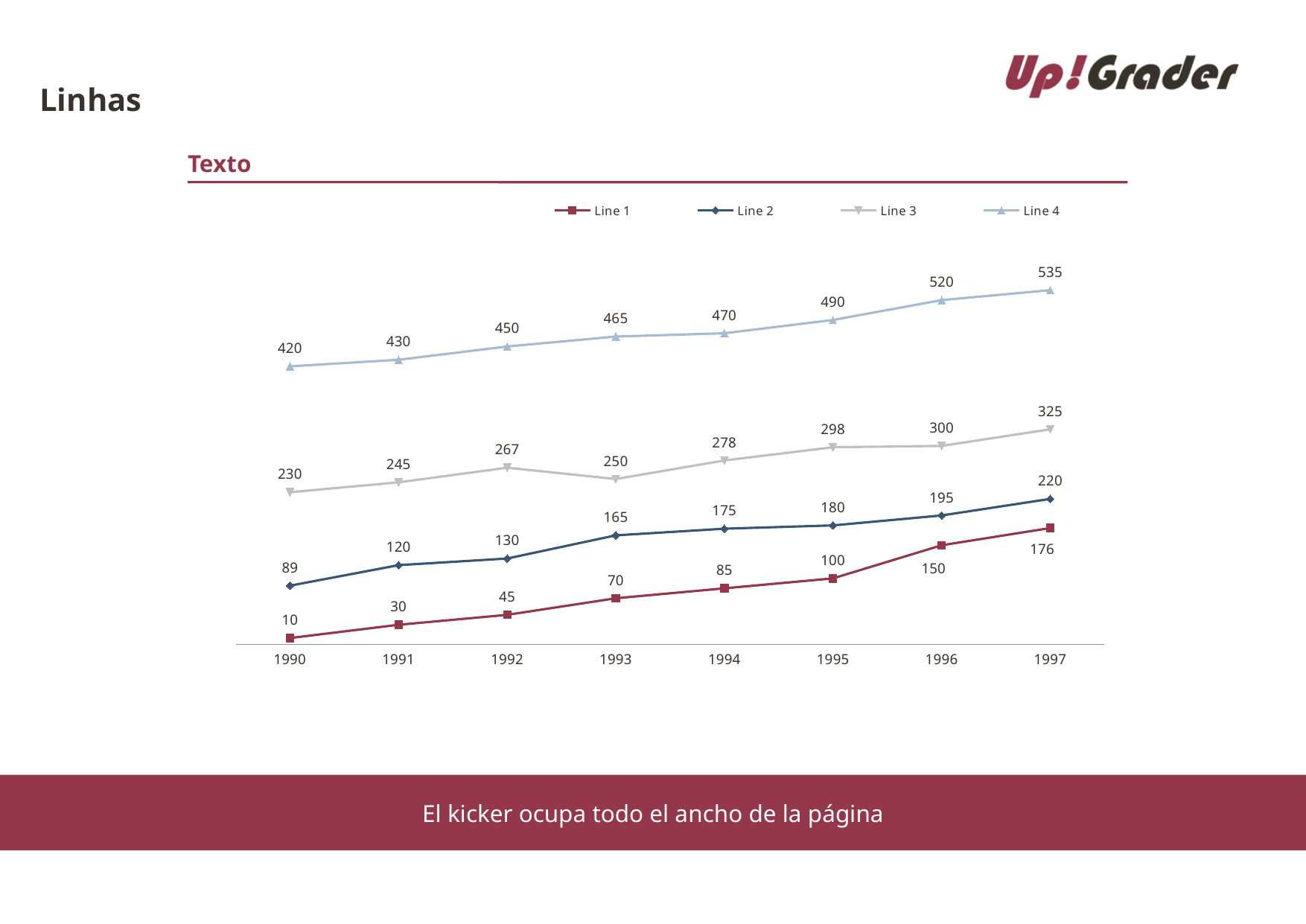
What kind of chart is shown on the slide? Line chart What is the difference between Line 4 and Line 3 in 1997? 210 What is the value of Line 2 in 1997? 220 Which is larger in 1996: Line 2 or Line 1? Line 2 In which year does Line 1 reach its highest value? 1997 What is the value of Line 3 in 1992? 267 In which year is Line 3 at its lowest value? 1990 What is the value of Line 1 in 1993? 70 How many years are shown on the x axis? 8 What is the value of Line 4 in 1995? 490 How many series does the legend list? 4 Does Line 2 rise or fall from 1990 to 1997? Rise